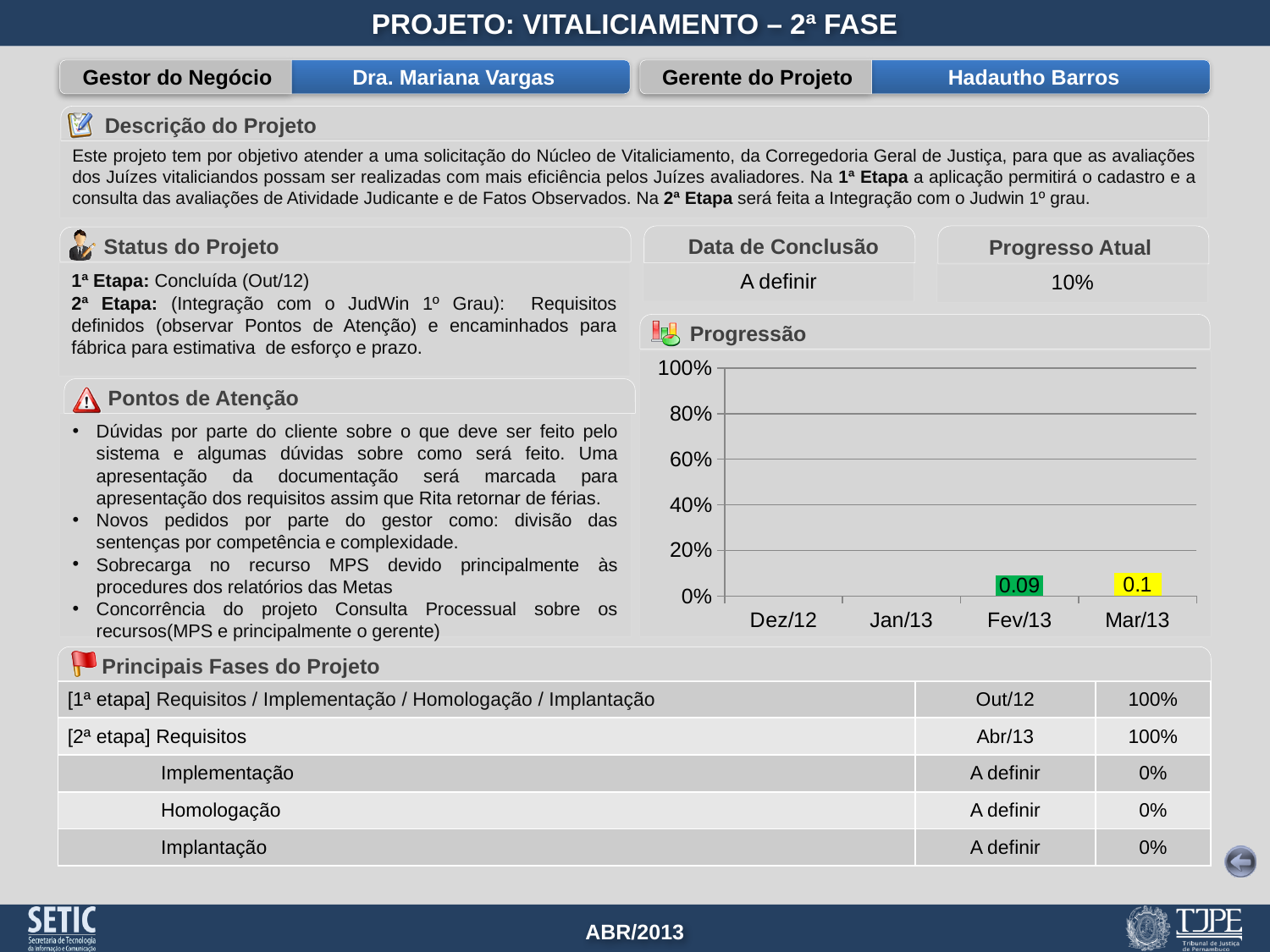
What is the difference between the values for Mar/13 and Fev/13 in the Progressão chart? 0.01 Do the labelled values in the Progressão chart rise or fall from Fev/13 to Mar/13? rise How many categories are shown on the x axis of the Progressão chart? 4 What is the value shown for Fev/13 in the Progressão chart? 0.09 What is the highest value shown on the y axis of the Progressão chart? 100% Which month has the highest labelled value in the Progressão chart? Mar/13 Which is larger in the Progressão chart, the value for Fev/13 or the value for Mar/13? Mar/13 What is the value shown for Mar/13 in the Progressão chart? 0.1 What kind of chart is the Progressão chart? bar chart What is the title of the chart on the slide? Progressão What is the first category on the x axis of the Progressão chart? Dez/12 Is the value for Mar/13 in the Progressão chart greater or less than 20%? less